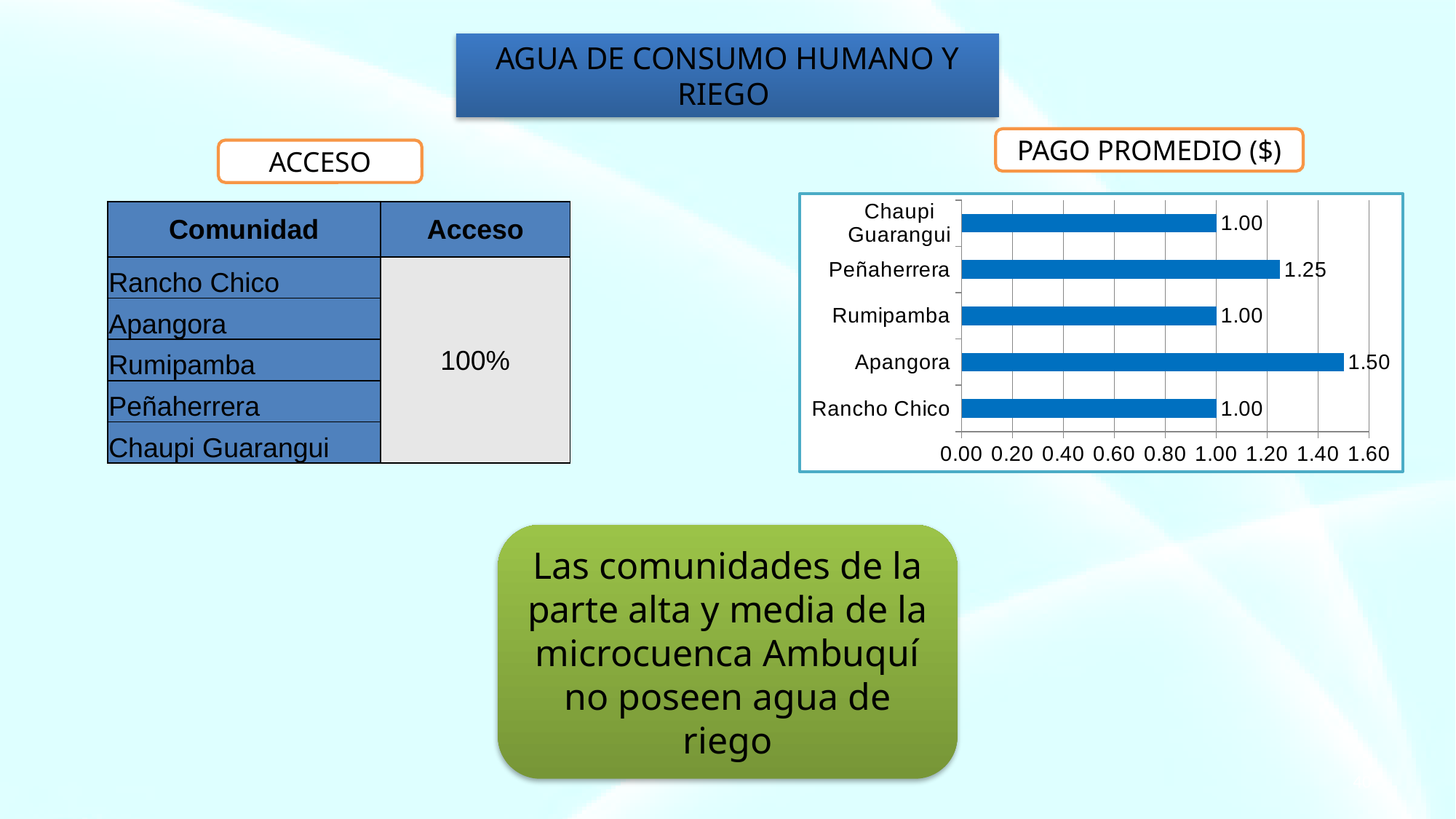
What is the difference between the values for Apangora and Rumipamba in the PAGO PROMEDIO ($) chart? 0.50 How many communities are shown in the PAGO PROMEDIO ($) chart? 5 What kind of chart is the PAGO PROMEDIO ($) chart? bar chart Which community has the highest value in the PAGO PROMEDIO ($) chart? Apangora What is the value for Rancho Chico in the PAGO PROMEDIO ($) chart? 1.00 What is the difference between the values for Apangora and Peñaherrera in the PAGO PROMEDIO ($) chart? 0.25 What is the maximum value shown on the axis of the PAGO PROMEDIO ($) chart? 1.60 In the PAGO PROMEDIO ($) chart, which is larger, the value for Peñaherrera or the value for Chaupi Guarangui? Peñaherrera What is the value for Apangora in the PAGO PROMEDIO ($) chart? 1.50 Is the value for Apangora in the PAGO PROMEDIO ($) chart greater or less than 1.40? greater What is the value for Peñaherrera in the PAGO PROMEDIO ($) chart? 1.25 How many communities in the PAGO PROMEDIO ($) chart have a value of 1.00? 3